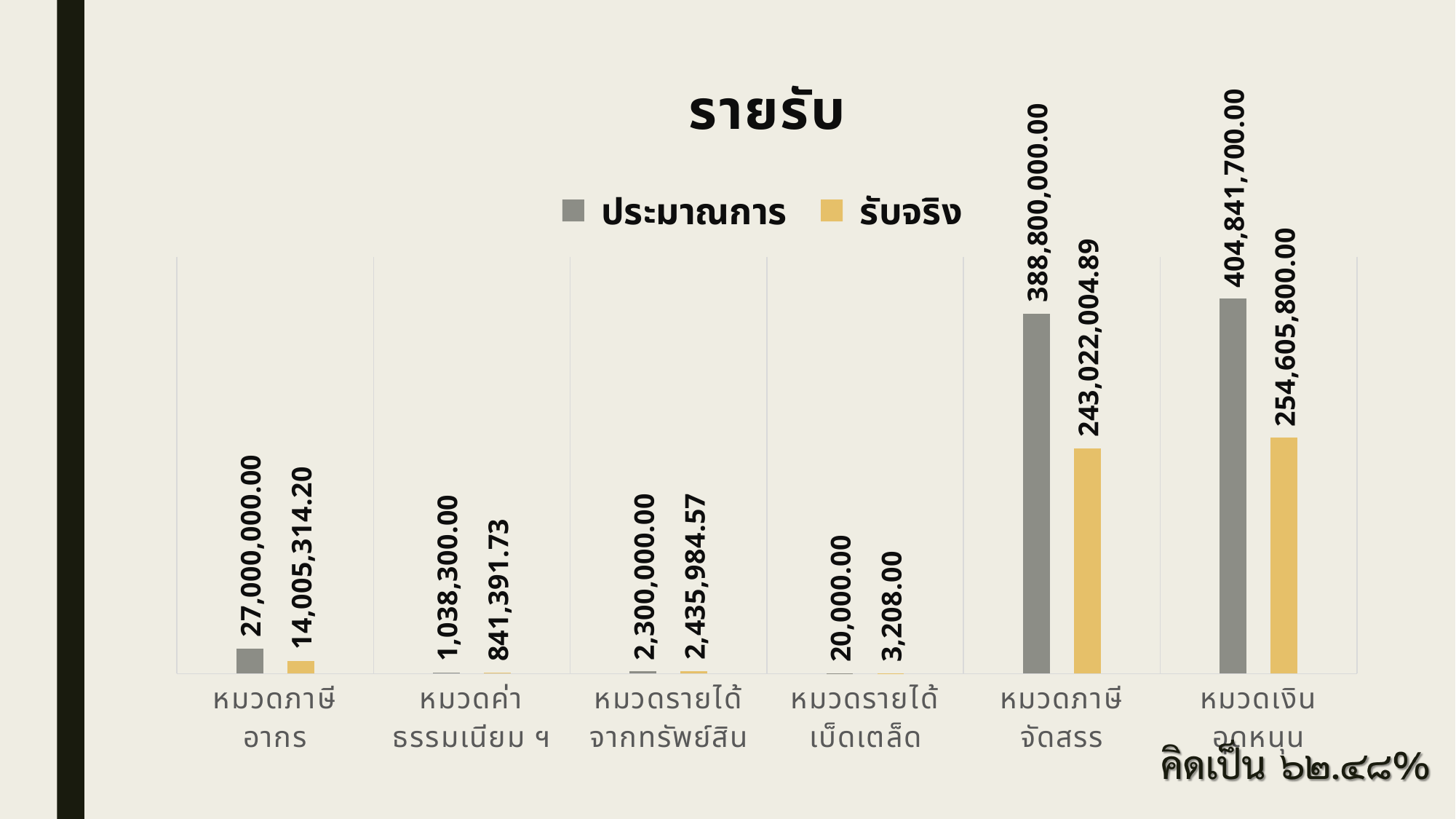
What is the รับจริง value for หมวดรายได้เบ็ดเตล็ด? 3,208.00 How many series does the legend list? 2 What type of chart is shown on the slide? bar chart Which colour represents the รับจริง series in the legend? gold Which category has the lowest รับจริง value? หมวดรายได้เบ็ดเตล็ด What is the title of the chart? รายรับ What is the difference between the ประมาณการ and รับจริง values for หมวดเงินอุดหนุน? 150,235,900.00 What is the รับจริง value for หมวดภาษีจัดสรร? 243,022,004.89 What is the ประมาณการ value for หมวดภาษีอากร? 27,000,000.00 Which category has the highest ประมาณการ value? หมวดเงินอุดหนุน How many categories are shown on the x axis? 6 For หมวดรายได้จากทรัพย์สิน, which is larger: ประมาณการ or รับจริง? รับจริง